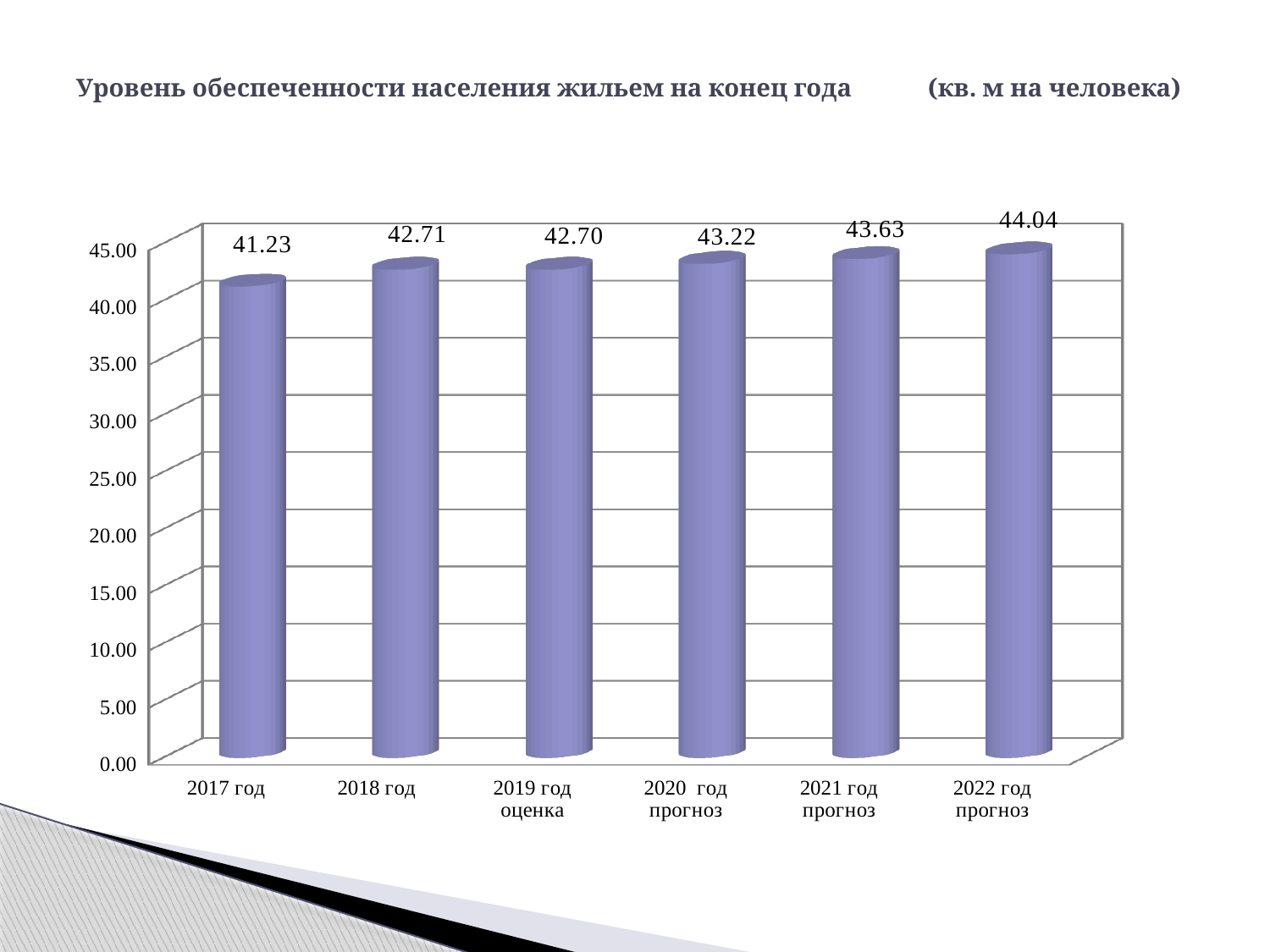
How many years are shown on the x axis? 6 What is the value for 2022 год прогноз? 44.04 Which is larger, the value for 2021 год прогноз or the value for 2017 год? 2021 год прогноз What kind of chart is shown on the slide? bar chart What is the difference between the values for 2021 год прогноз and 2020 год прогноз? 0.41 Which year has the highest value? 2022 год прогноз What is the value for 2020 год прогноз? 43.22 Which year has the lowest value? 2017 год What is the difference between the values for 2022 год прогноз and 2017 год? 2.81 Is the value for 2017 год greater or less than 40.00? greater What is the value for 2019 год оценка? 42.70 What is the value for 2017 год? 41.23